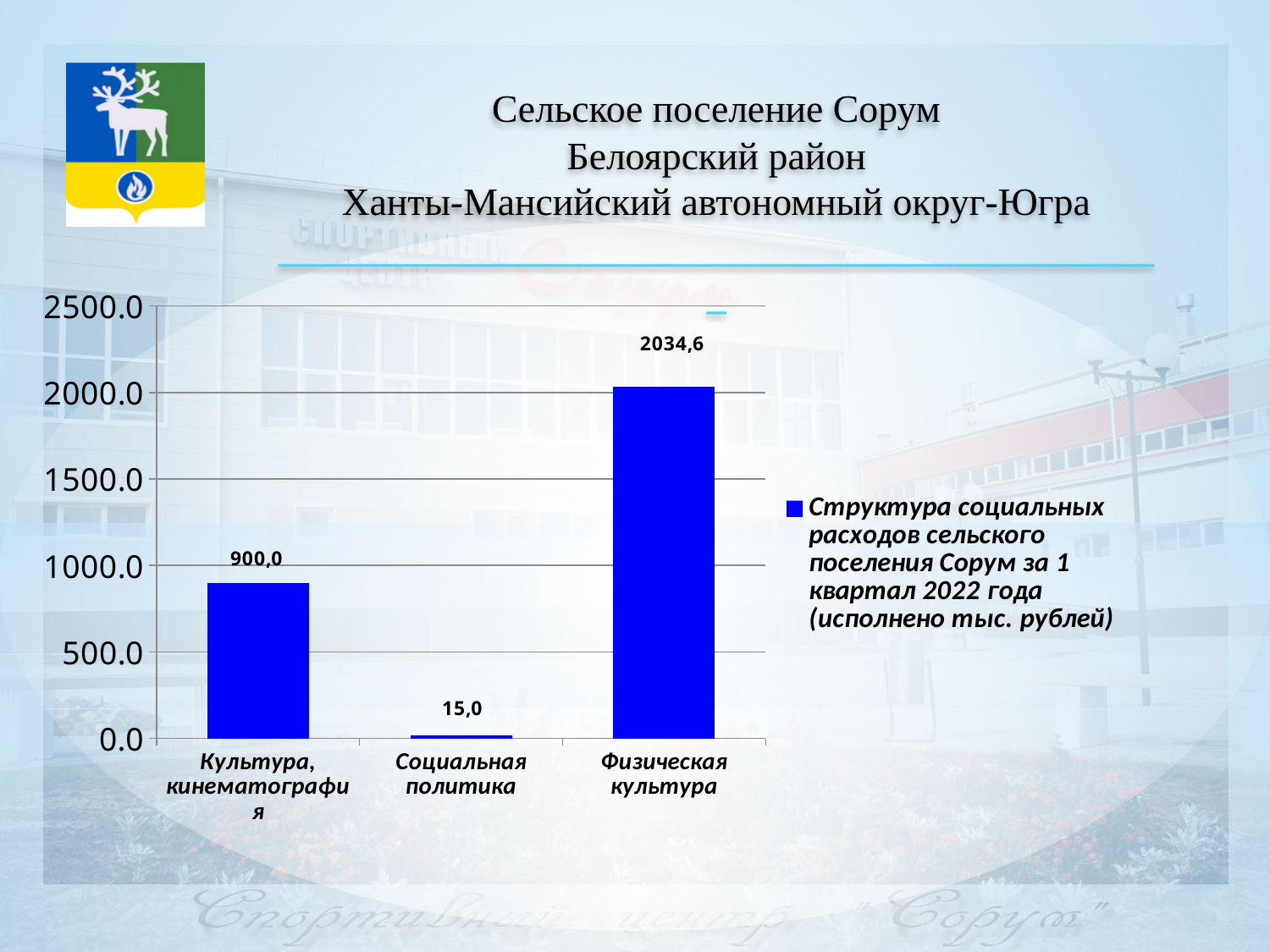
How many series does the legend list? 1 What is the value for Социальная политика? 15,0 Is the value for Физическая культура greater or less than 2000.0? greater What is the difference between the values for Культура, кинематография and Социальная политика? 885,0 Which category has the highest value? Физическая культура What is the value for Физическая культура? 2034,6 What kind of chart is shown on the slide? bar chart What is the difference between the values for Физическая культура and Культура, кинематография? 1134,6 How many categories are shown on the x axis? 3 What is the value for Культура, кинематография? 900,0 Which is larger, the value for Культура, кинематография or the value for Социальная политика? Культура, кинематография Which category has the lowest value? Социальная политика